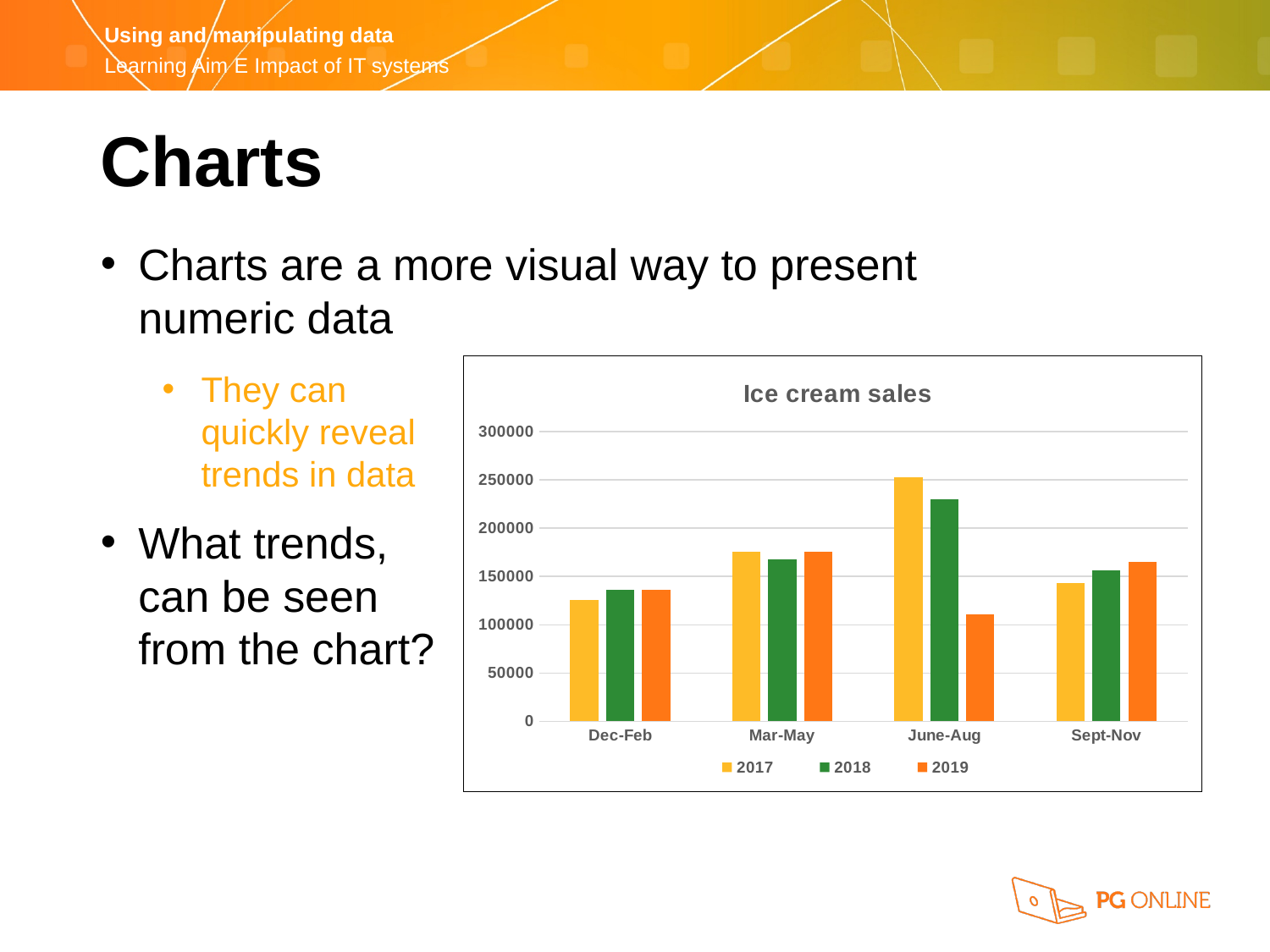
Is the value for 2019 in June-Aug greater or less than 150000? less How many categories are shown on the x axis? 4 In Sept-Nov, which year has the larger sales value, 2017 or 2019? 2019 Is the value for 2017 in Dec-Feb greater or less than 150000? less In June-Aug, which year has the larger sales value, 2017 or 2019? 2017 In which period are the 2017 ice cream sales highest? June-Aug What kind of chart is shown on the slide? bar chart What is the title of the chart? Ice cream sales How many series does the legend list? 3 In which period are the 2018 ice cream sales highest? June-Aug Is the value for 2017 in June-Aug greater or less than 200000? greater In which period are the 2019 ice cream sales lowest? June-Aug